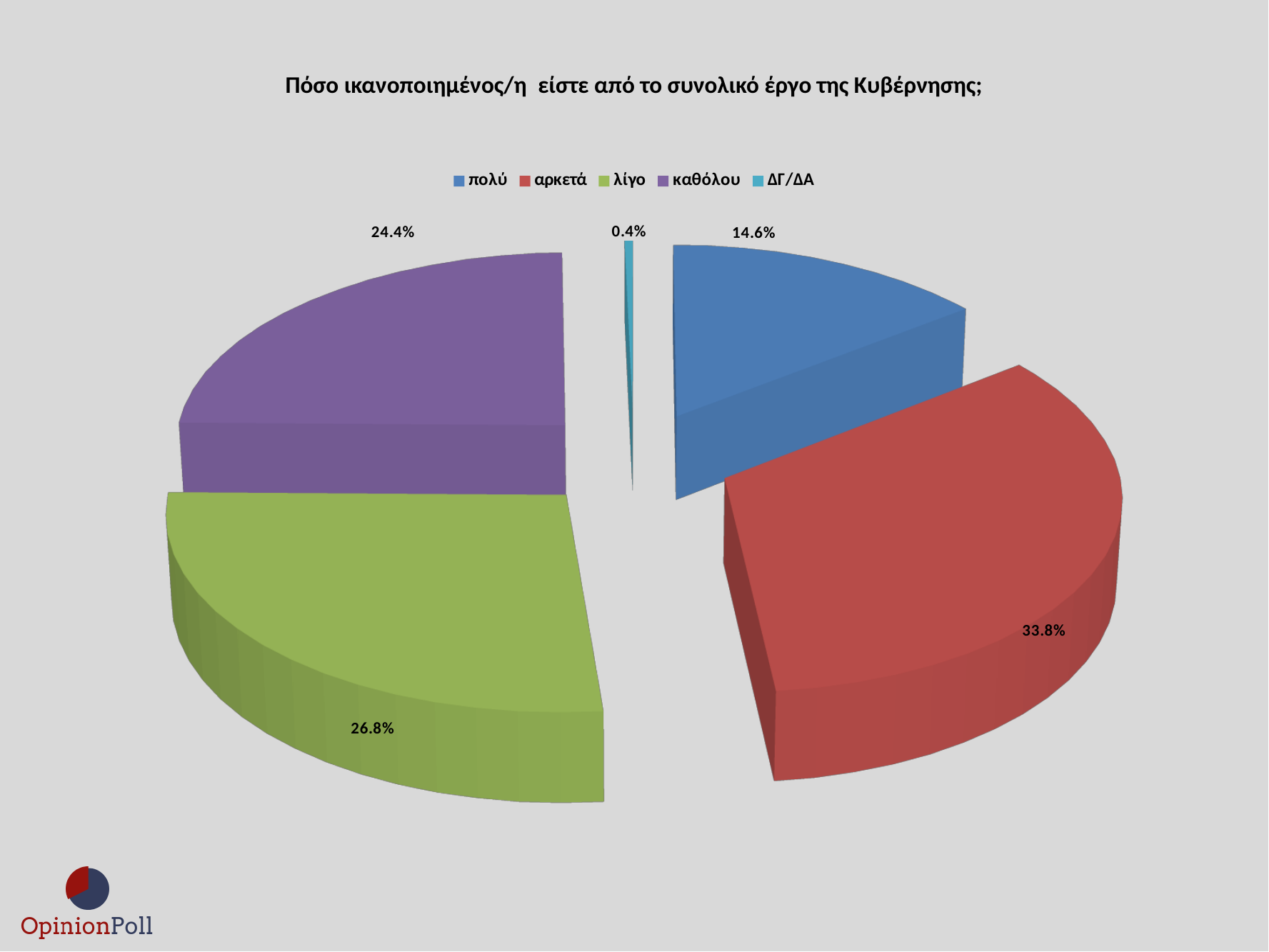
How many categories does the legend list? 5 What percentage of respondents answered "πολύ"? 14.6% What kind of chart is shown on the slide? Pie chart What percentage of respondents answered "αρκετά"? 33.8% What percentage of respondents answered "καθόλου"? 24.4% What is the difference in percentage points between "αρκετά" and "πολύ"? 19.2 What percentage of respondents answered "ΔΓ/ΔΑ"? 0.4% Which response category has the smallest share of the pie? ΔΓ/ΔΑ What percentage of respondents answered "λίγο"? 26.8% Which response category has the largest share of the pie? αρκετά Which is larger, the share for "λίγο" or the share for "καθόλου"? λίγο What colour is the slice for "καθόλου"? Purple